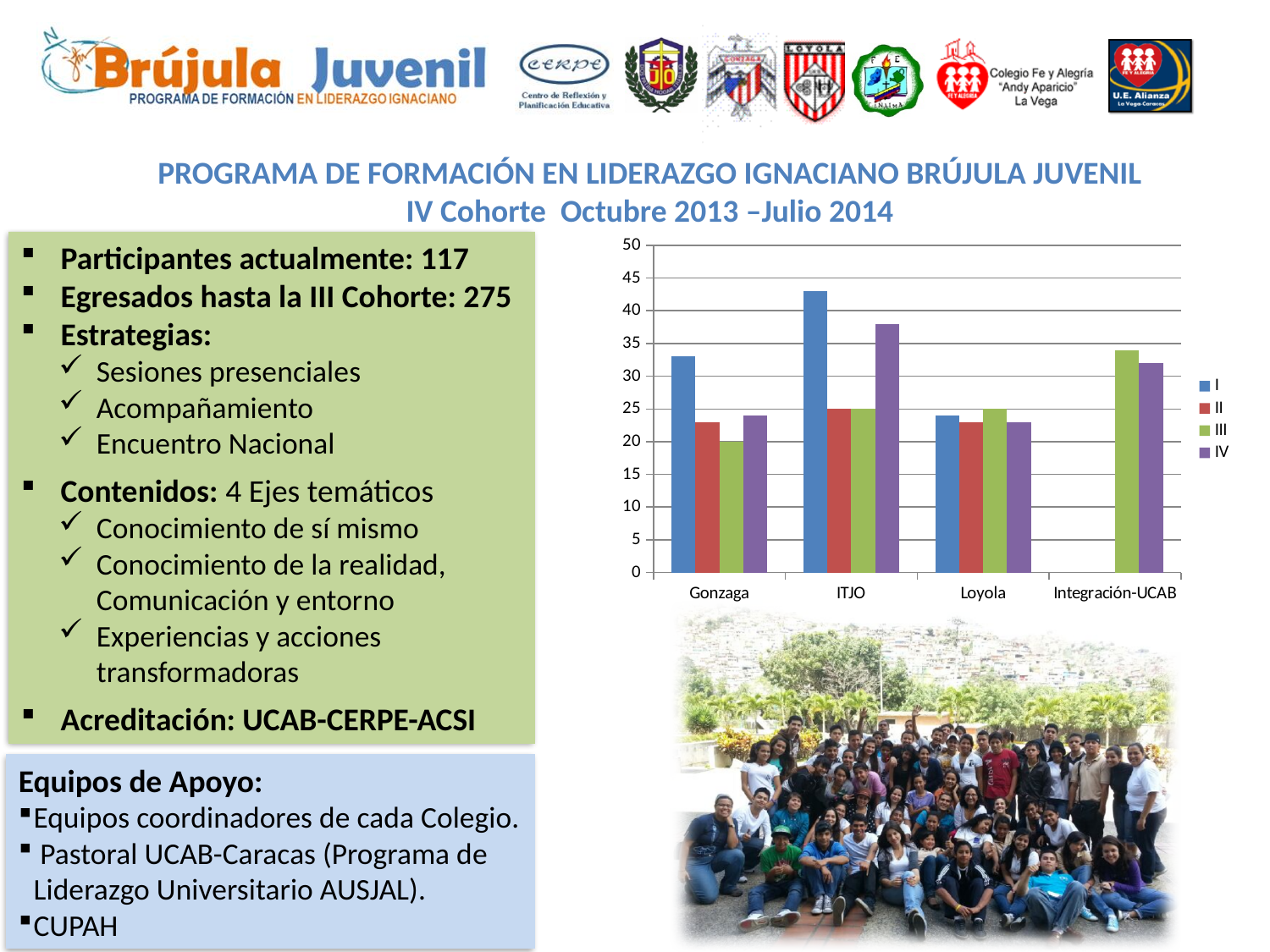
What kind of chart is shown on the slide? bar chart Is the value for series III at Integración-UCAB greater or less than 30? greater How many categories are shown on the x axis of the chart? 4 What are the entries listed in the chart legend? I, II, III, IV Which category has bars only for series III and IV? Integración-UCAB Is the value for series IV at ITJO greater or less than 35? greater Is the value for series I at Gonzaga greater or less than 30? greater For series IV, which is larger: ITJO or Loyola? ITJO How many series does the chart legend list? 4 Which category has the highest bar for series I? ITJO At Gonzaga, which is larger: the series I bar or the series II bar? series I